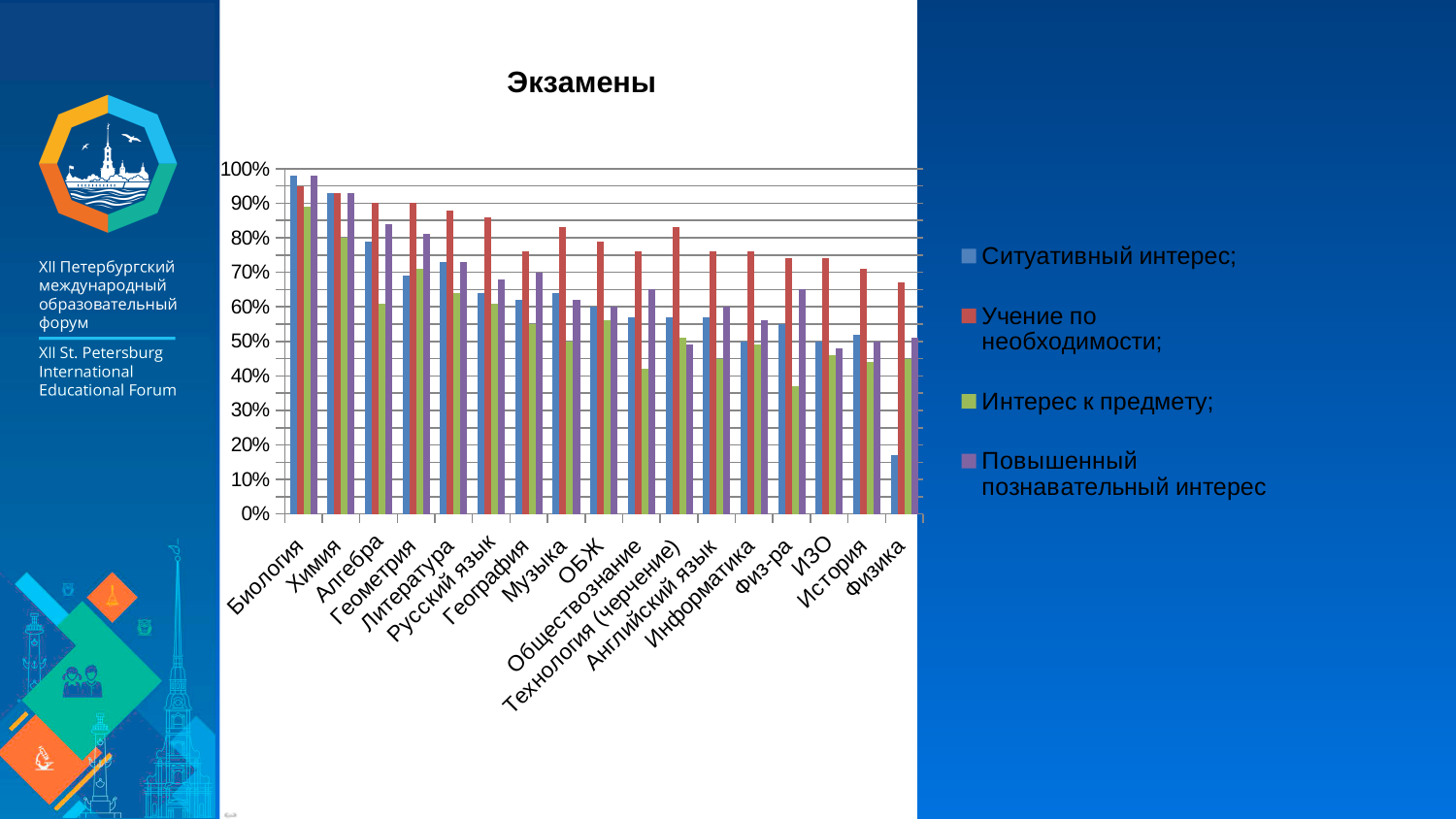
Which subject has the lowest value for Ситуативный интерес? Физика What is the title of the chart? Экзамены Is the value of Учение по необходимости for Химия greater or less than 90%? greater Is the value of Ситуативный интерес for Биология greater or less than 90%? greater For Физ-ра, which is larger: Интерес к предмету or Повышенный познавательный интерес? Повышенный познавательный интерес Do the values of Ситуативный интерес generally rise or fall from Биология to Физика along the x axis? fall What kind of chart is shown on the slide? bar chart Which series is shown in red in the legend? Учение по необходимости How many series does the legend list? 4 How many subject categories are shown on the x axis? 17 Is the value of Ситуативный интерес for Физика greater or less than 20%? less